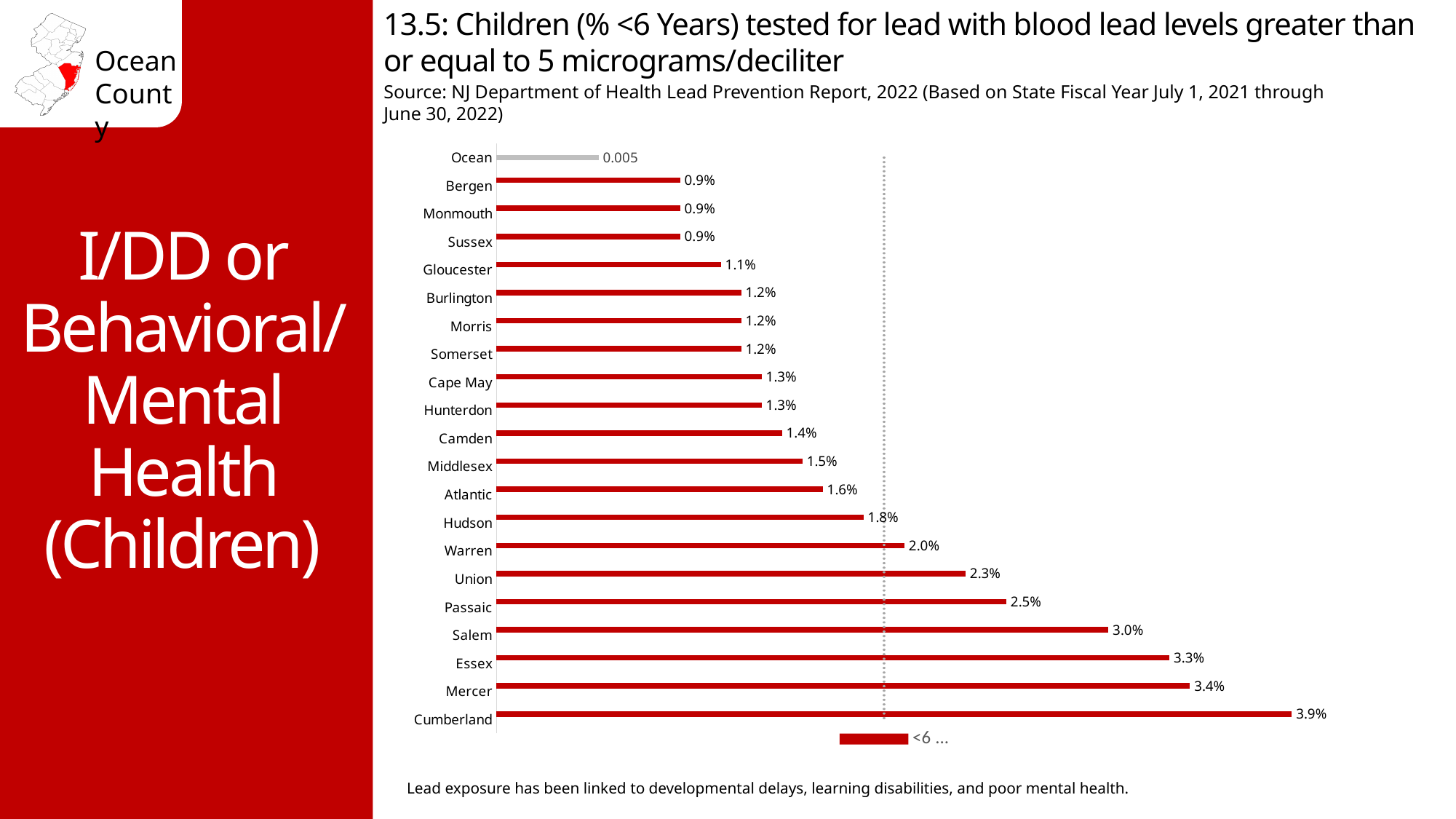
Which county has the lowest value? Ocean Which county has the highest value? Cumberland Which has a larger value, Atlantic or Hudson? Hudson What kind of chart is shown on the slide? Bar chart What value is shown for Ocean? 0.005 Which has a larger value, Union or Passaic? Passaic What value is shown for Passaic? 2.5% What is the difference between the values for Essex and Salem? 0.3% What value is shown for Hudson? 1.8% What is the difference between the values for Cumberland and Mercer? 0.5% What value is shown for Cumberland? 3.9% How many counties are shown in the chart? 21